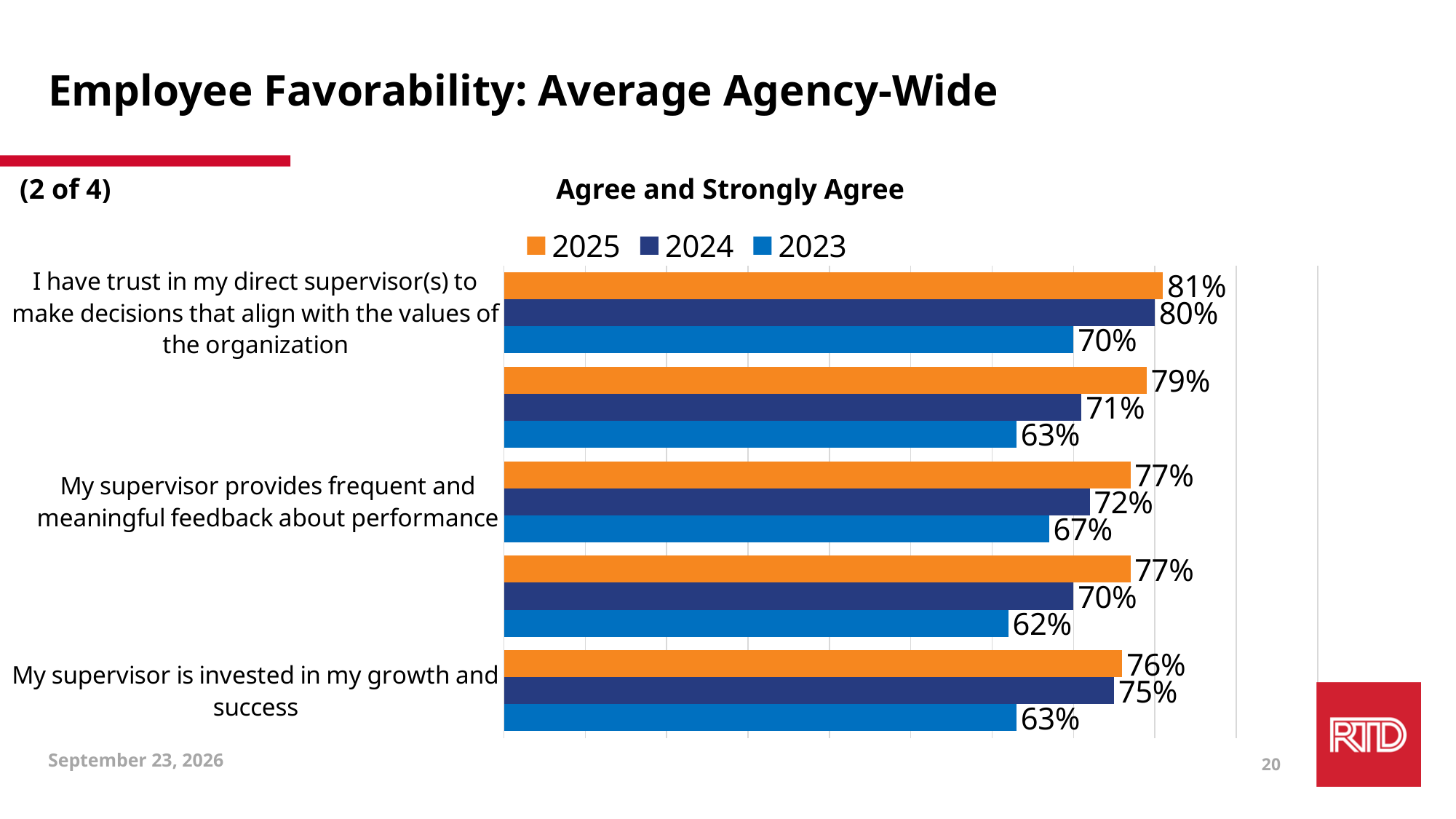
What kind of chart is shown on the slide? Bar chart What is the 2025 value for "I have trust in my direct supervisor(s) to make decisions that align with the values of the organization"? 81% How many series does the legend list? 3 What is the 2023 value for "I have trust in my direct supervisor(s) to make decisions that align with the values of the organization"? 70% What is the 2024 value for "My supervisor is invested in my growth and success"? 75% Which is larger for "My supervisor provides frequent and meaningful feedback about performance": the 2025 value or the 2023 value? 2025 What is the 2023 value for "My supervisor provides frequent and meaningful feedback about performance"? 67% What is the difference between the 2024 and 2023 values for "My supervisor provides frequent and meaningful feedback about performance"? 5% What is the subtitle shown above the chart legend? Agree and Strongly Agree What is the difference between the 2025 and 2023 values for "My supervisor is invested in my growth and success"? 13% Which year has the lowest value for "My supervisor is invested in my growth and success"? 2023 Which year has the highest value for "I have trust in my direct supervisor(s) to make decisions that align with the values of the organization"? 2025